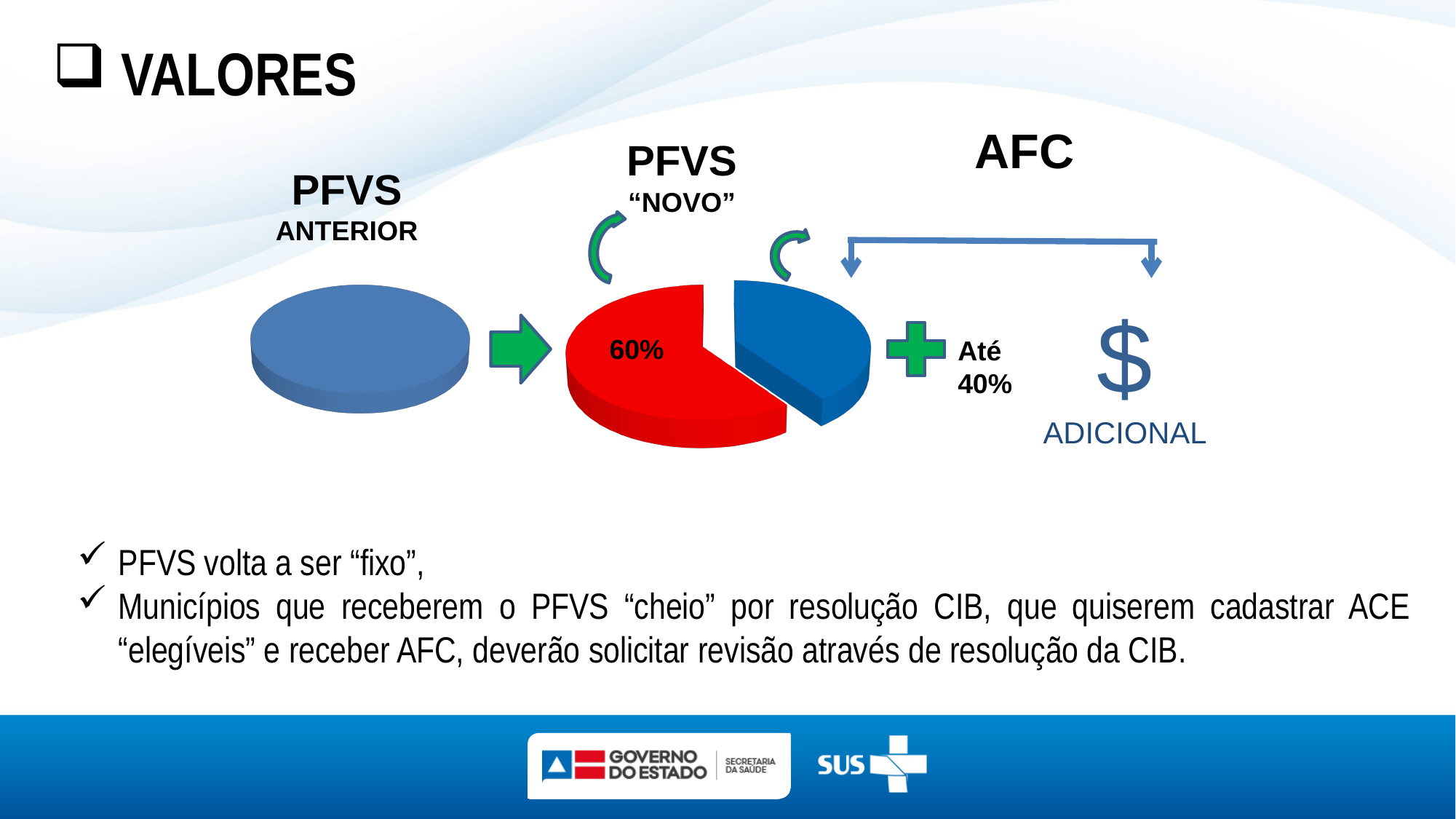
What kind of chart is used to show the split between PFVS "NOVO" and AFC? pie chart Is the share of the red slice in the pie chart greater or less than 50%? greater Which slice of the pie chart is larger, the red one or the blue one? the red one Which part of the pie chart represents the largest share? PFVS "NOVO" (60%) What label is printed next to the blue slice of the pie chart? Até 40% What percentage is printed on the red slice of the pie chart? 60% What colour is the slice labelled 60% in the pie chart? red What is the heading written above the red 60% slice of the pie chart? PFVS "NOVO" How many slices does the exploded pie chart have? 2